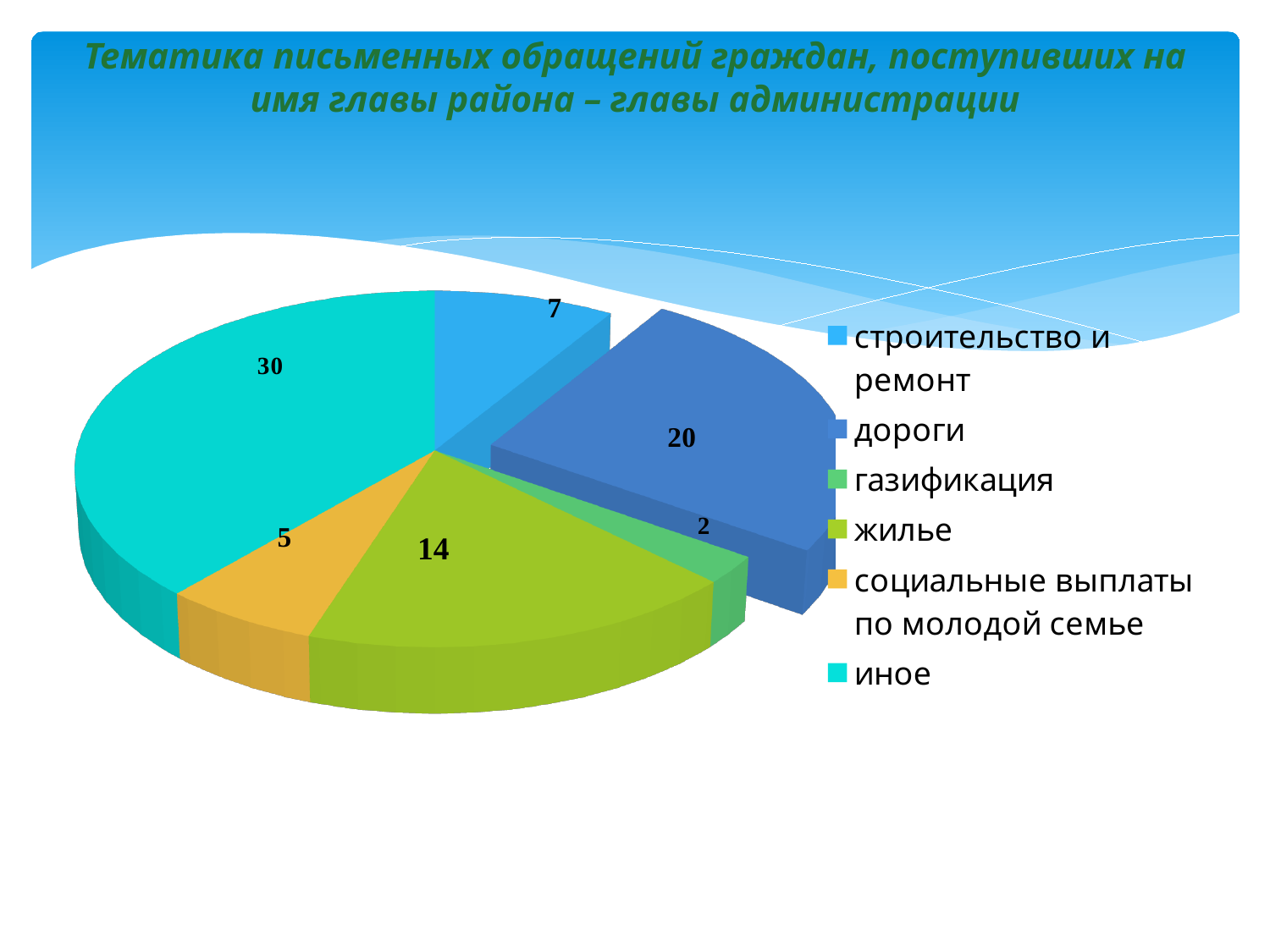
How many categories does the pie chart show? 6 What is the difference between the values for иное and дороги? 10 Which is larger, жилье or строительство и ремонт? жилье What is the value for жилье? 14 Which category has the largest slice? иное What colour is the slice for дороги? blue What is the value for газификация? 2 What is the value for иное? 30 What kind of chart is shown on the slide? pie chart What is the value for социальные выплаты по молодой семье? 5 What is the value for дороги? 20 Which category has the smallest slice? газификация